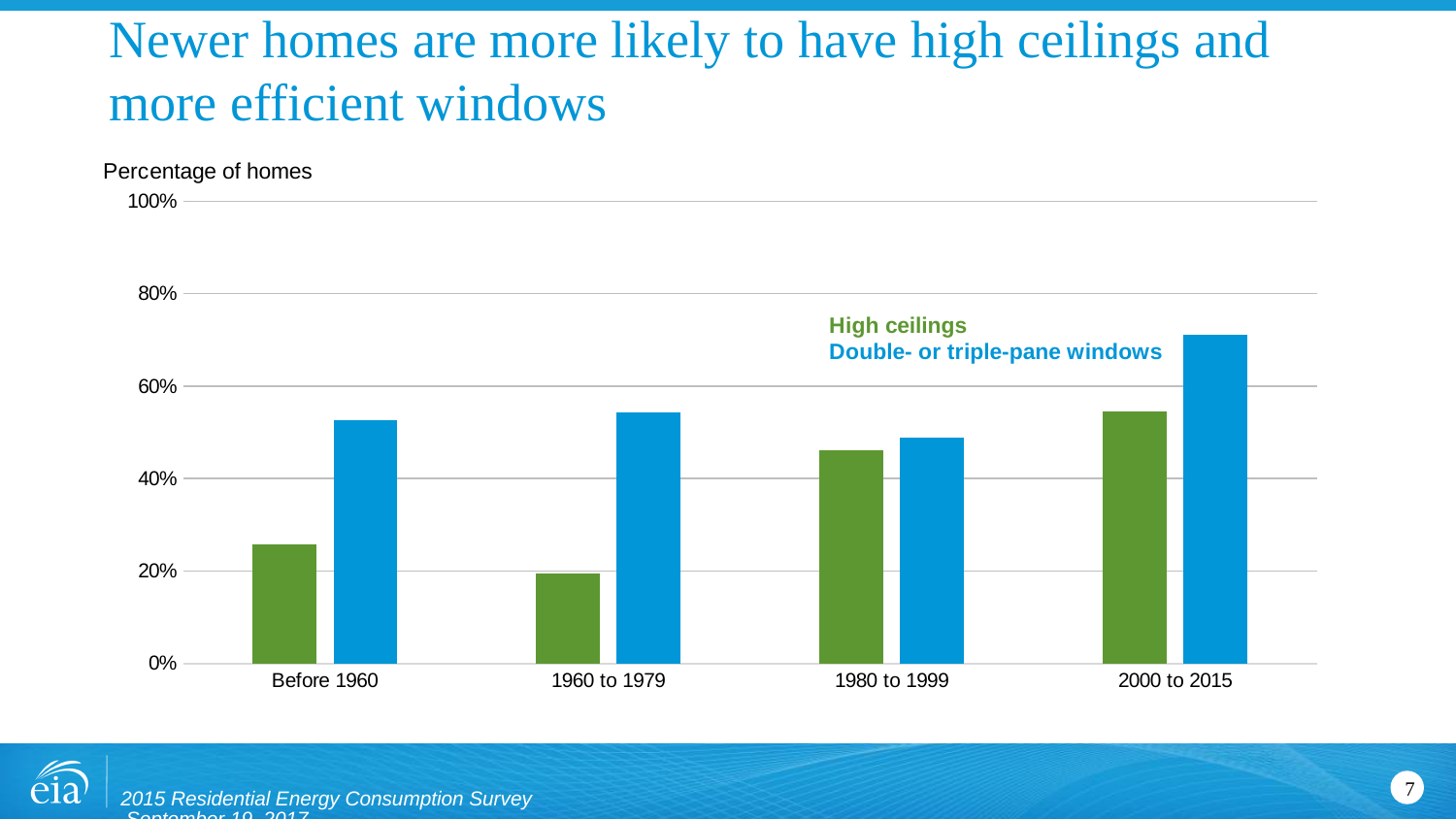
Is the value for High ceilings in homes built 1980 to 1999 greater or less than 60%? less How many series does the chart's legend list? 2 Which is larger: High ceilings for Before 1960 or High ceilings for 1960 to 1979? Before 1960 Which colour represents the High ceilings series? green Which category has the highest value for Double- or triple-pane windows? 2000 to 2015 Which category has the lowest value for High ceilings? 1960 to 1979 How many home-age categories are shown on the x axis? 4 What is the label on the vertical axis of the chart? Percentage of homes Which category has the highest value for High ceilings? 2000 to 2015 Is the value for High ceilings in homes built Before 1960 greater or less than 20%? greater What kind of chart is shown on the slide? bar chart Is the value for Double- or triple-pane windows in homes built 2000 to 2015 greater or less than 60%? greater